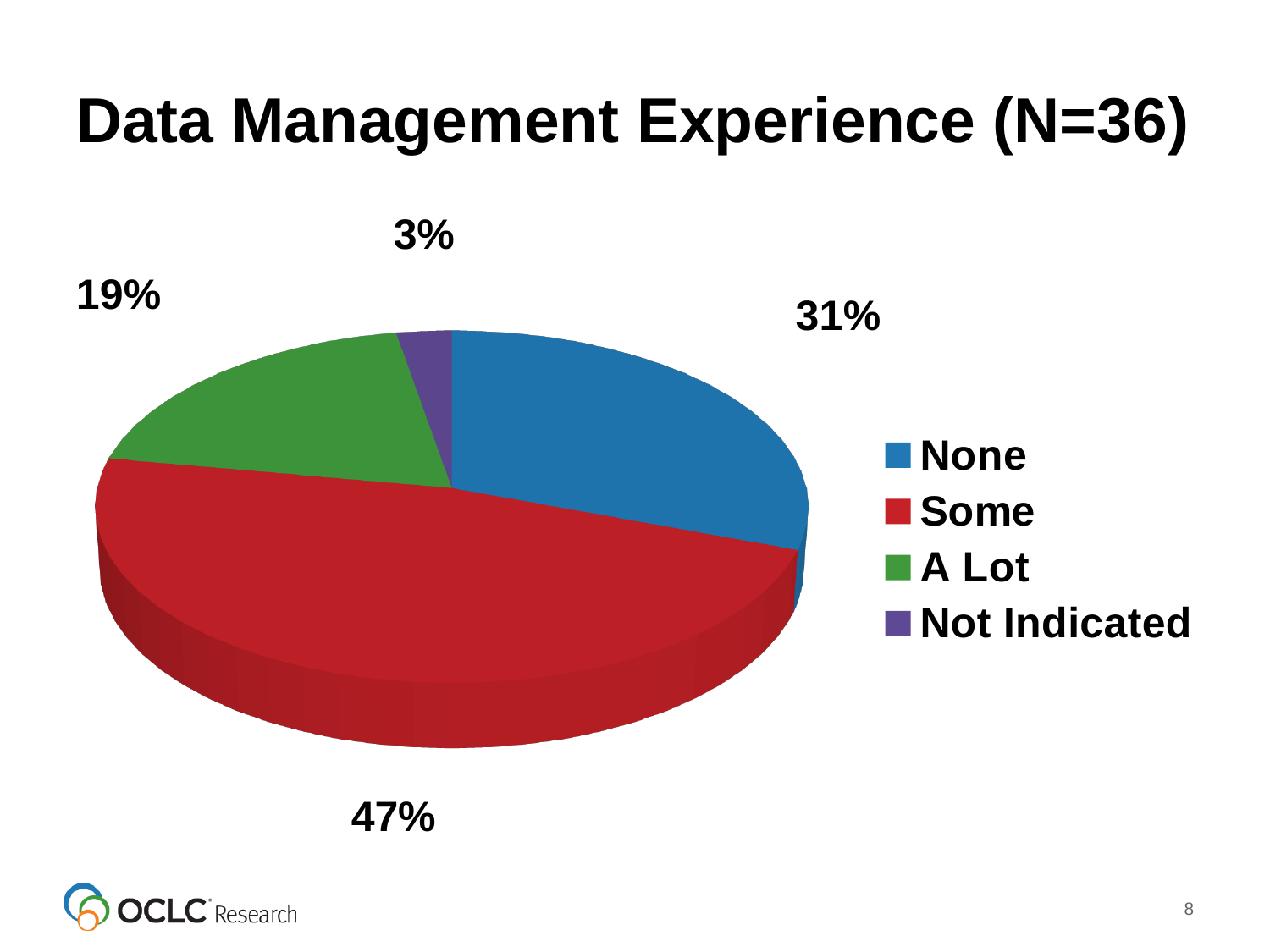
What kind of chart is shown on the slide? pie chart Which category has the smallest share of the pie? Not Indicated Which is larger, the share for 'None' or the share for 'A Lot'? None What percentage of respondents reported 'None' for data management experience? 31% How many categories does the pie chart have? 4 What percentage of respondents reported 'Some' data management experience? 47% Which category has the largest share of the pie? Some What percentage of respondents are in the 'Not Indicated' category? 3% What is the title of the chart? Data Management Experience (N=36) What percentage of respondents reported 'A Lot' of data management experience? 19% What is the difference in percentage points between 'Some' and 'None'? 16 What colour represents the 'A Lot' category in the legend? green